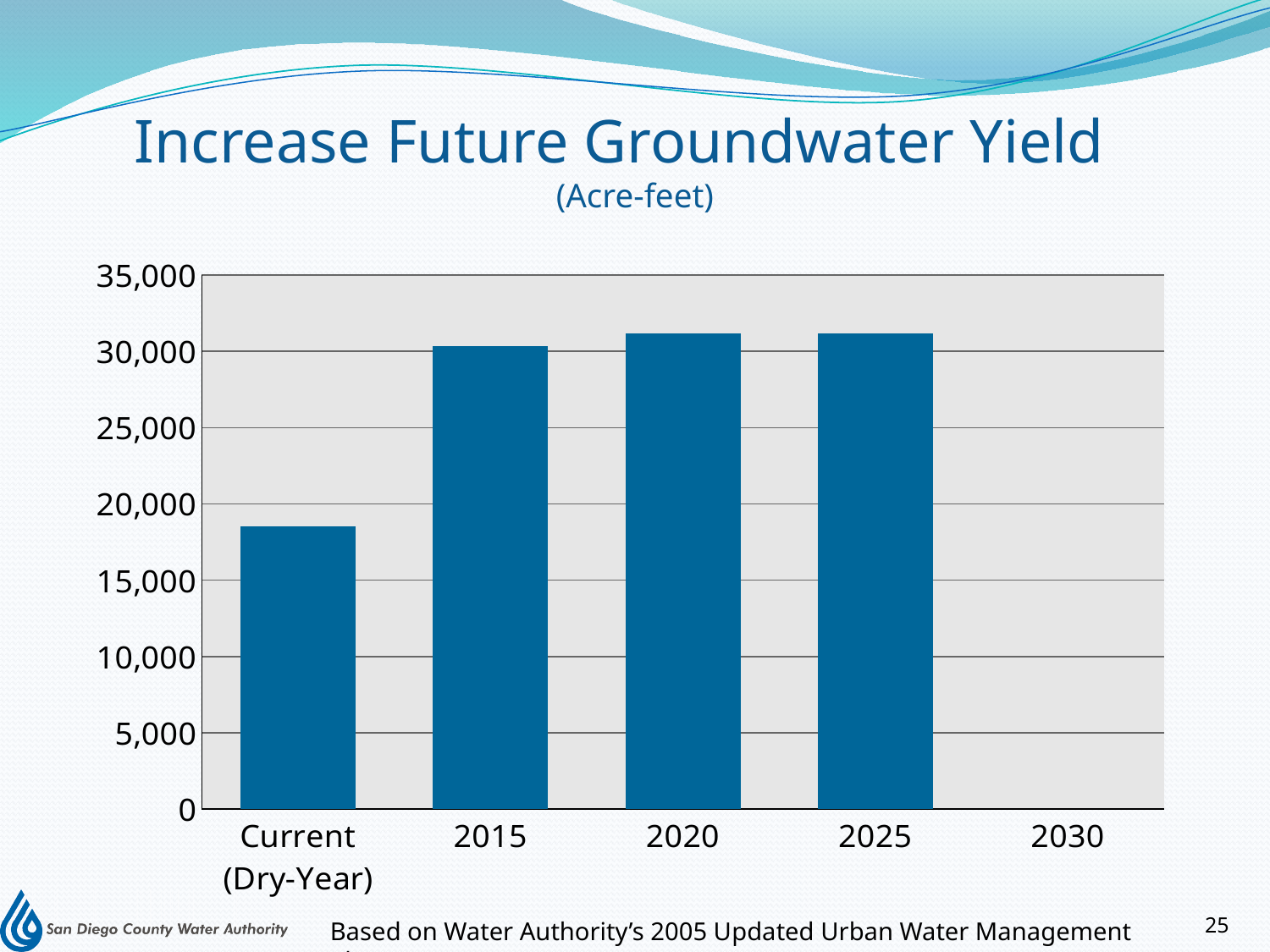
How many categories are labelled on the x axis? 5 What kind of chart is shown on the slide? bar chart Is the value for Current (Dry-Year) greater or less than 15,000? greater Do the values rise or fall from Current (Dry-Year) to 2025? rise Which is larger, the value for Current (Dry-Year) or the value for 2015? 2015 Is the value for 2025 greater or less than 25,000? greater Is the value for 2020 greater or less than 35,000? less In what units are the values on the chart expressed? Acre-feet Which category has the lowest value? Current (Dry-Year) What is the title of the chart? Increase Future Groundwater Yield